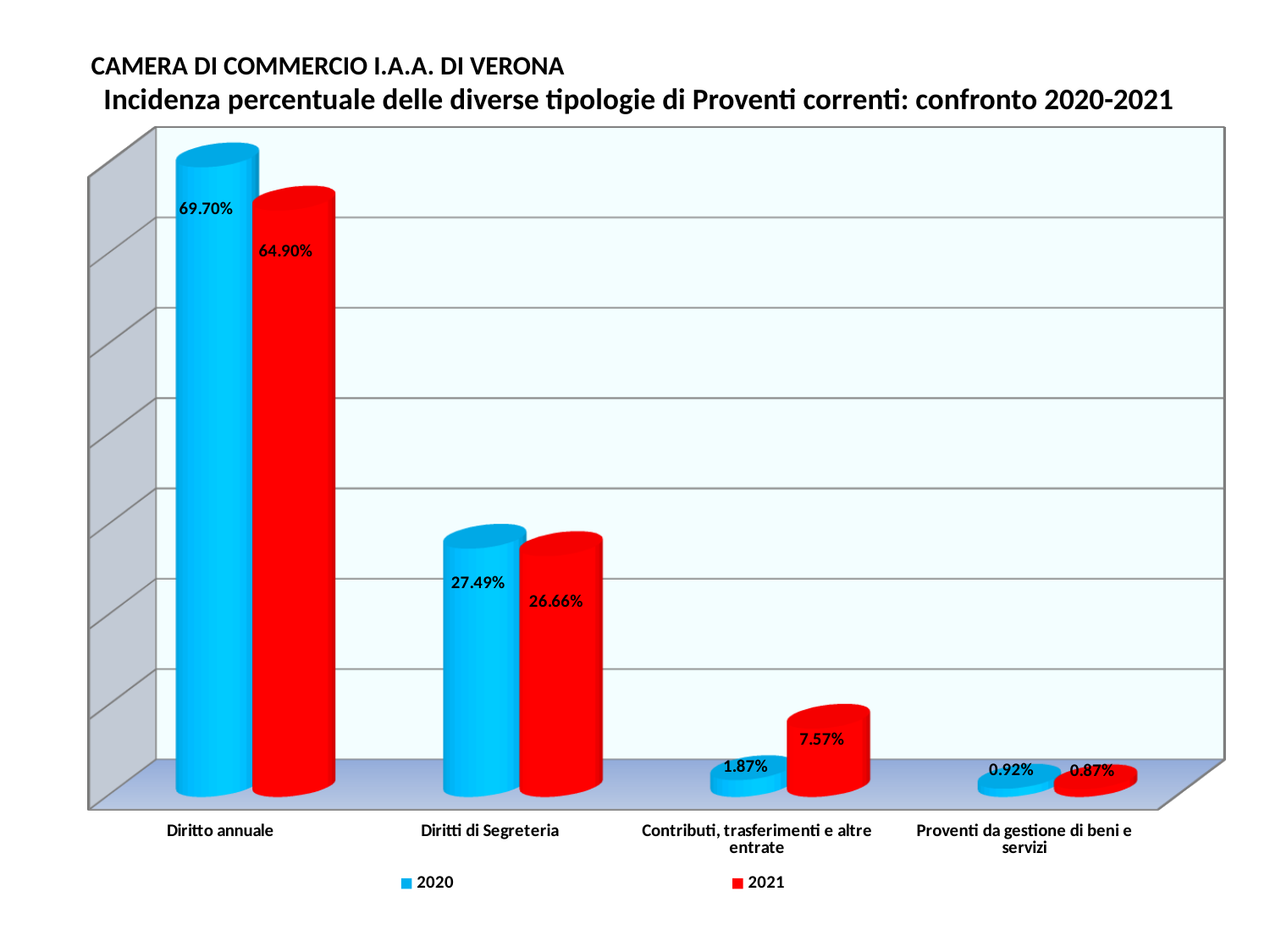
What is the value for Diritto annuale in 2020? 69.70% How many series does the legend list? 2 What is the value for Proventi da gestione di beni e servizi in 2021? 0.87% What is the value for Diritti di Segreteria in 2021? 26.66% Which category has the lowest value in 2020? Proventi da gestione di beni e servizi What is the value for Contributi, trasferimenti e altre entrate in 2020? 1.87% For Contributi, trasferimenti e altre entrate, which year has the larger value, 2020 or 2021? 2021 What is the difference between the 2021 and 2020 values for Contributi, trasferimenti e altre entrate? 5.70% What is the difference between the 2020 and 2021 values for Diritto annuale? 4.80% What is the value for Diritto annuale in 2021? 64.90% Which category has the highest value in 2021? Diritto annuale How many categories are shown on the x axis? 4